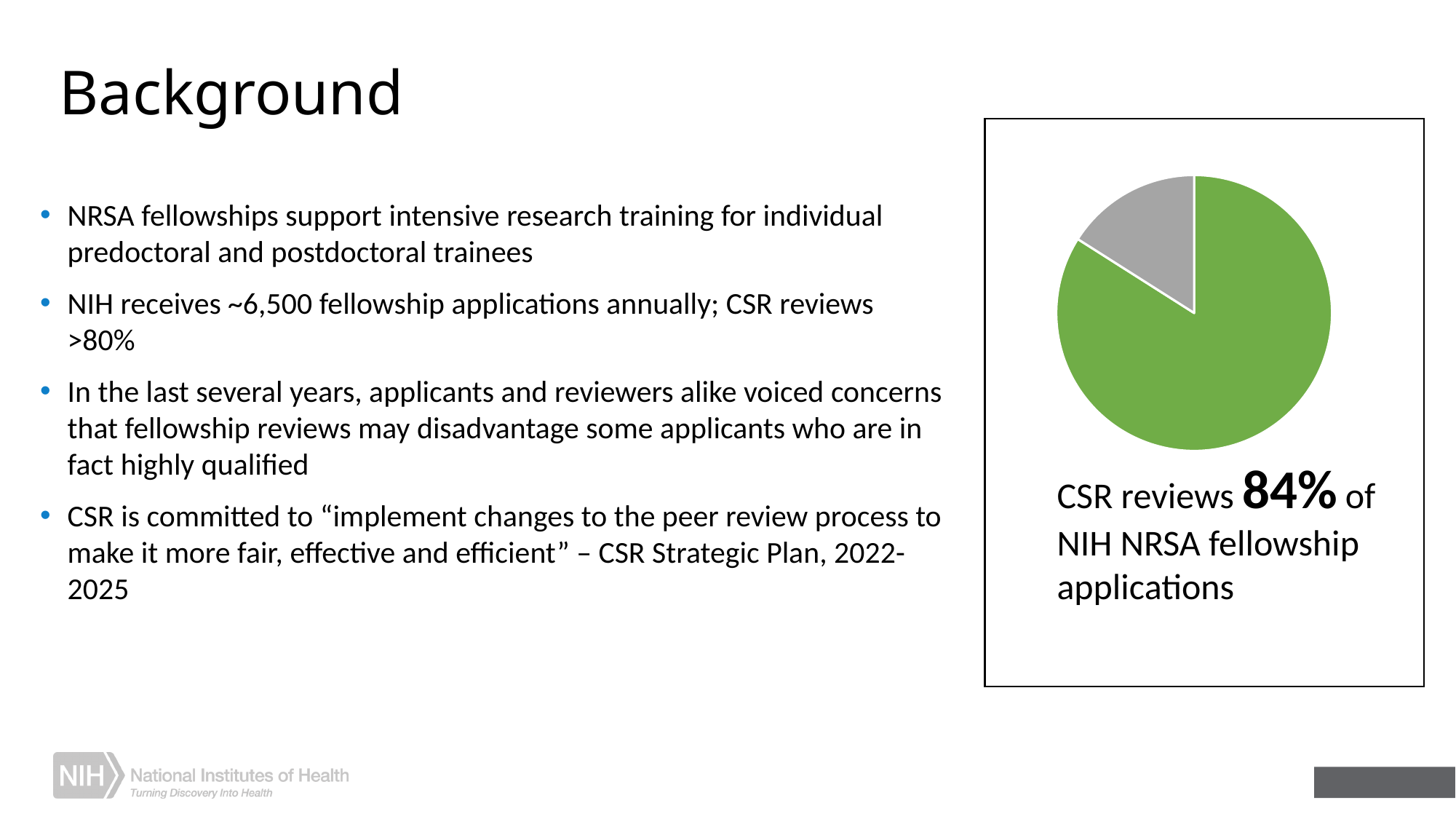
Is the share of the gray slice greater or less than 25%? less What colour is the slice representing the applications CSR reviews? green According to the pie chart caption, what percentage of NIH NRSA fellowship applications does CSR review? 84% What kind of chart is shown on the slide? pie chart Which slice of the pie chart is larger, the green one or the gray one? green What share of the pie does the gray slice represent? 16% Is the share of the green slice greater or less than 50%? greater How many slices does the pie chart have? 2 What share of the pie does the green slice represent? 84% Which slice of the pie chart is the smallest? the gray slice What does the caption below the pie chart say? CSR reviews 84% of NIH NRSA fellowship applications